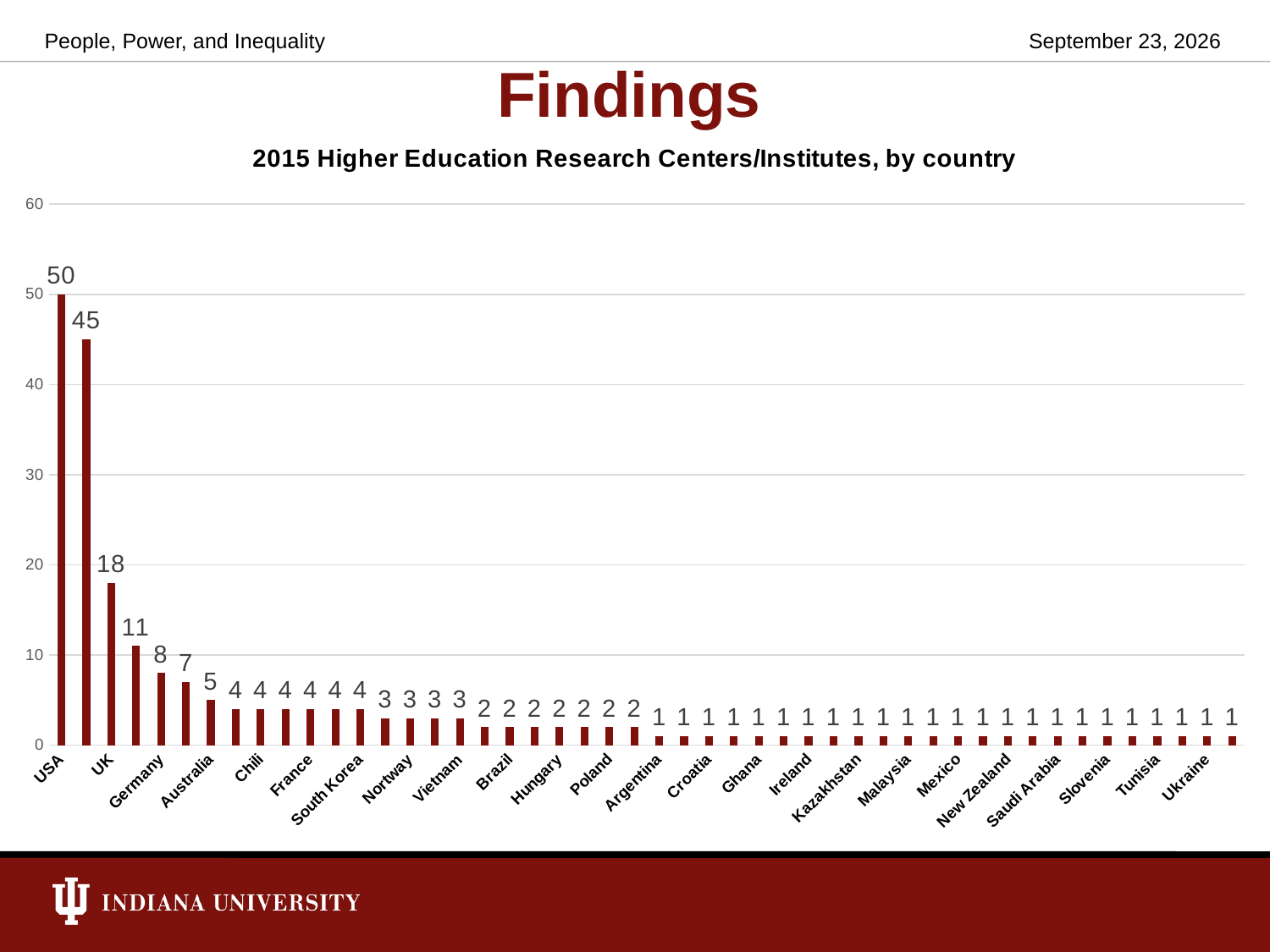
What is the value shown for Brazil? 2 What is the value shown for Chili? 4 How many higher education research centers/institutes does the USA have? 50 What is the difference between the values for the USA and Ukraine? 49 Which country has the highest number of higher education research centers/institutes? USA What is the value shown for Norway? 3 What type of chart is shown on the slide? Bar chart Do the values generally rise or fall moving from left to right along the x axis? Fall What is the value shown for Mexico? 1 What is the title of the chart? 2015 Higher Education Research Centers/Institutes, by country Which has a larger value, the USA or France? USA What is the value shown for Ukraine? 1